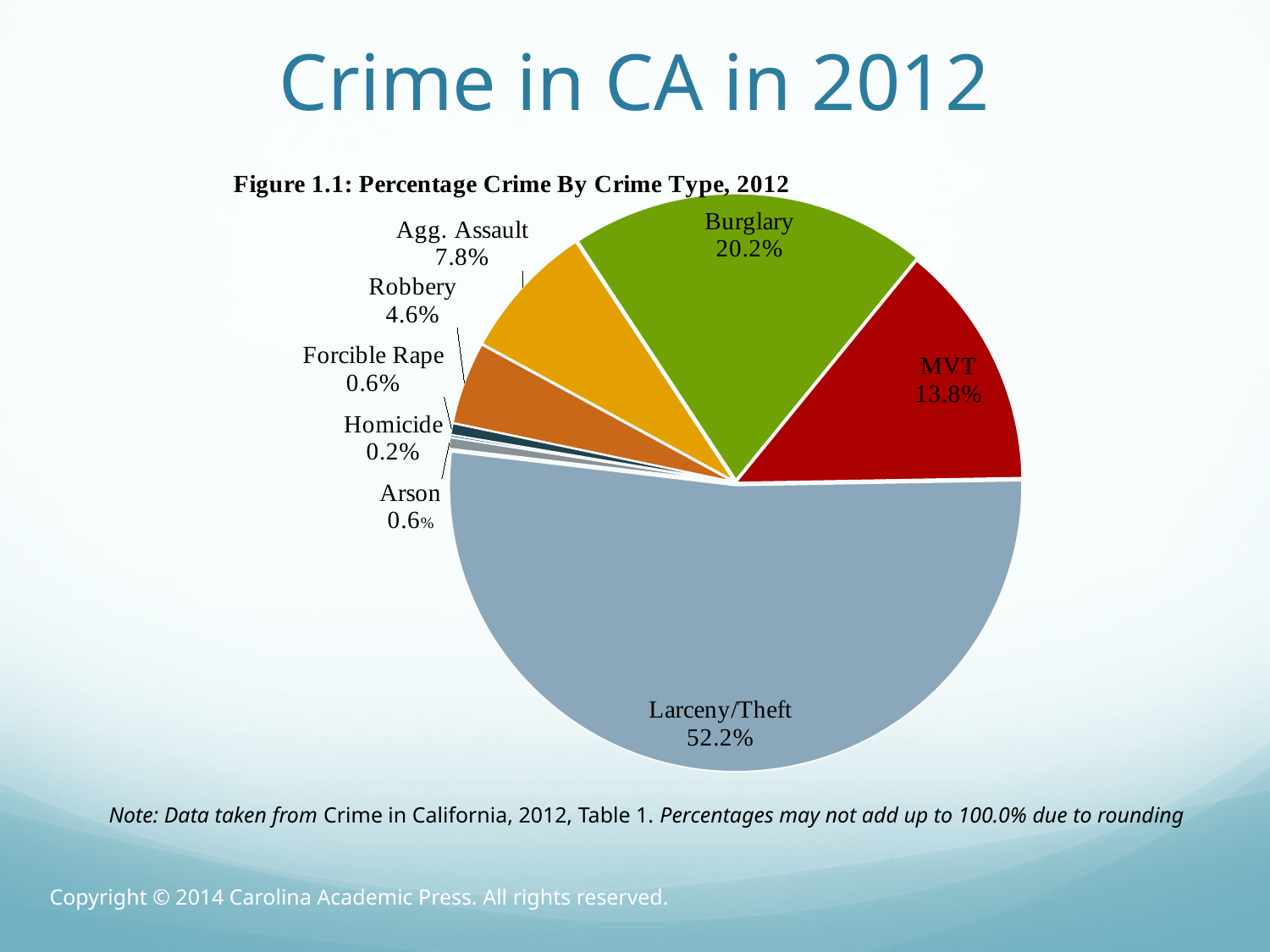
What percentage of crime is Robbery? 4.6% What percentage of crime is MVT? 13.8% What percentage of crime is Homicide? 0.2% What percentage of crime is Larceny/Theft? 52.2% What percentage of crime is Agg. Assault? 7.8% How many crime types are shown in the pie chart? 8 Which crime type has the largest share of the pie? Larceny/Theft Which crime type has the smallest share of the pie? Homicide What percentage of crime is Burglary? 20.2% What is the title of the chart? Figure 1.1: Percentage Crime By Crime Type, 2012 What is the difference in percentage points between Burglary and MVT? 6.4 What kind of chart is shown on the slide? Pie chart